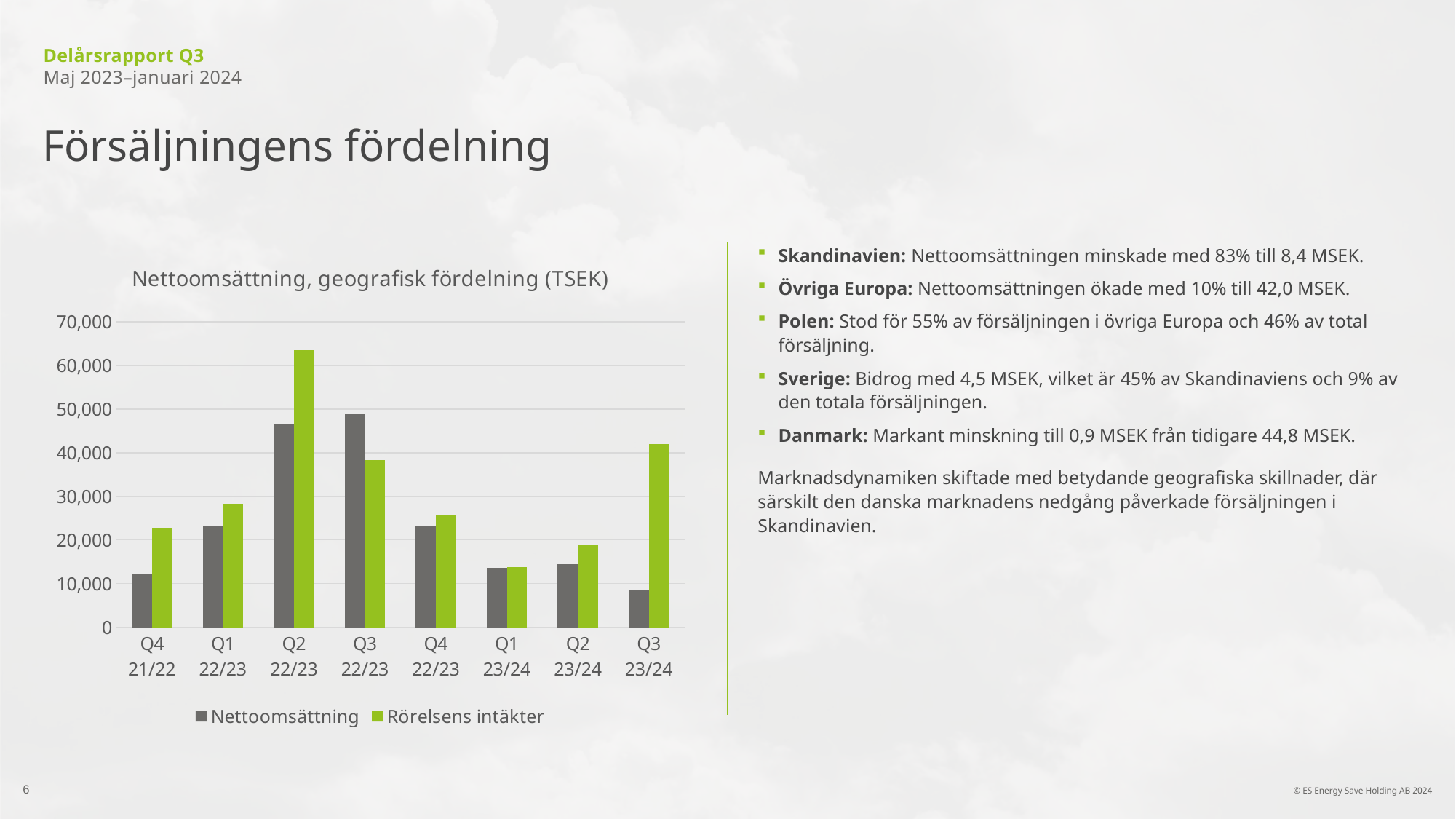
In Q3 23/24, which is larger: Nettoomsättning or Rörelsens intäkter? Rörelsens intäkter Is the value of Nettoomsättning for Q3 23/24 greater or less than 10,000? less How many series does the chart legend list? 2 In which quarter is Rörelsens intäkter highest? Q2 22/23 In which quarter is Nettoomsättning lowest? Q3 23/24 Is the value of Rörelsens intäkter for Q3 23/24 greater or less than 40,000? greater In Q3 22/23, which is larger: Nettoomsättning or Rörelsens intäkter? Nettoomsättning In which quarter is Rörelsens intäkter lowest? Q1 23/24 What is the title of the chart? Nettoomsättning, geografisk fördelning (TSEK) How many quarters are shown on the x axis of the chart? 8 What kind of chart is shown on the slide? Bar chart Is the value of Rörelsens intäkter for Q2 22/23 greater or less than 60,000? greater